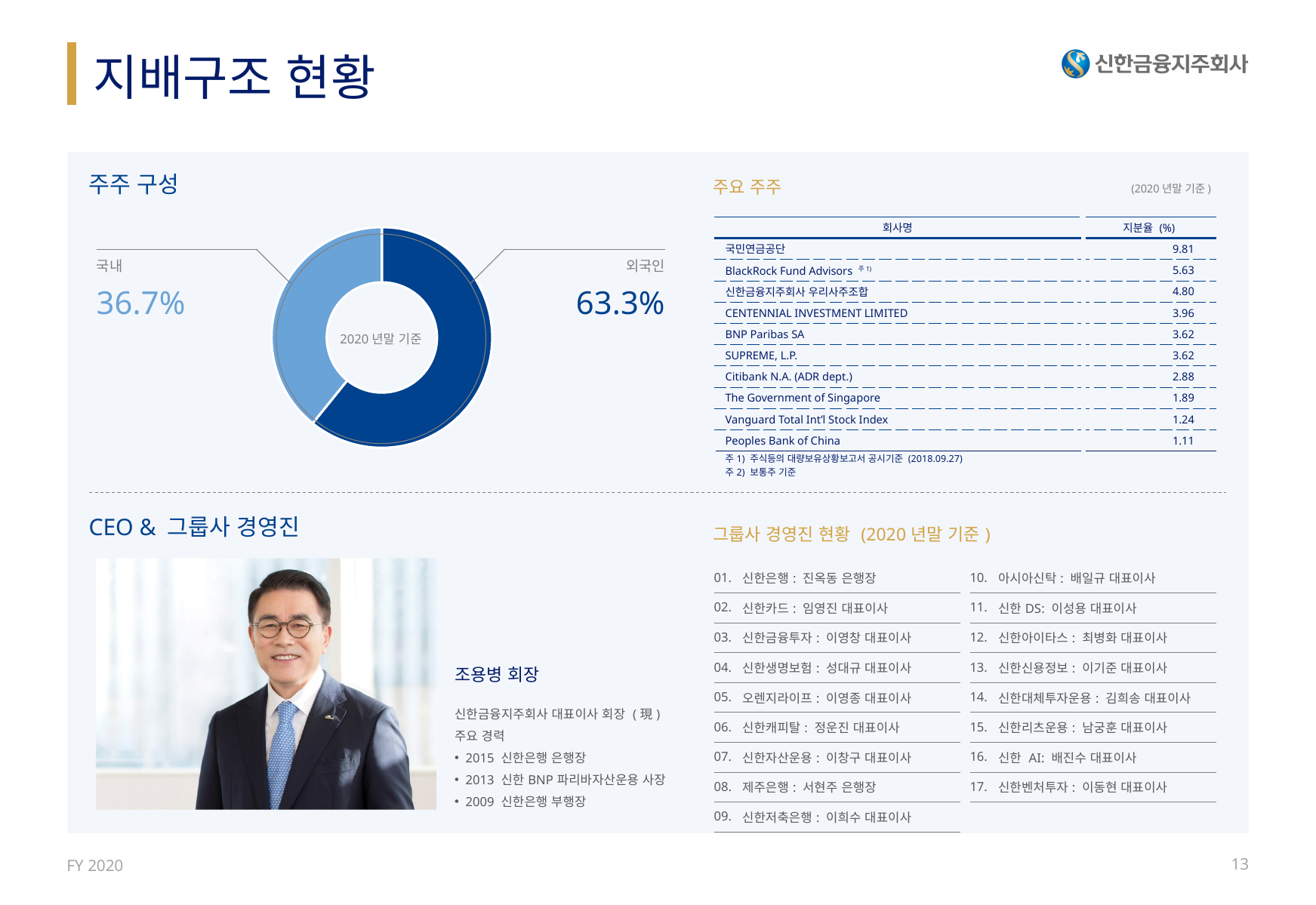
What kind of chart is shown under 주주 구성? Donut (pie) chart In the 주주 구성 chart, is the share for 외국인 greater or less than 50%? Greater In the 주주 구성 chart, which category has the larger share? 외국인 How many slices does the 주주 구성 chart have? 2 In the 주주 구성 chart, which slice is drawn in the darker blue colour? 외국인 What text is written in the centre of the 주주 구성 donut chart? 2020 년말 기준 In the 주주 구성 chart, is the share for 국내 larger or smaller than the share for 외국인? Smaller In the 주주 구성 chart, what share is shown for 외국인? 63.3% In the 주주 구성 chart, what share is shown for 국내? 36.7% In the 주주 구성 chart, which category has the smaller share? 국내 In the 주주 구성 chart, what is the difference in percentage points between 외국인 and 국내? 26.6 percentage points In the 주주 구성 chart, what do the two slices add up to? 100%